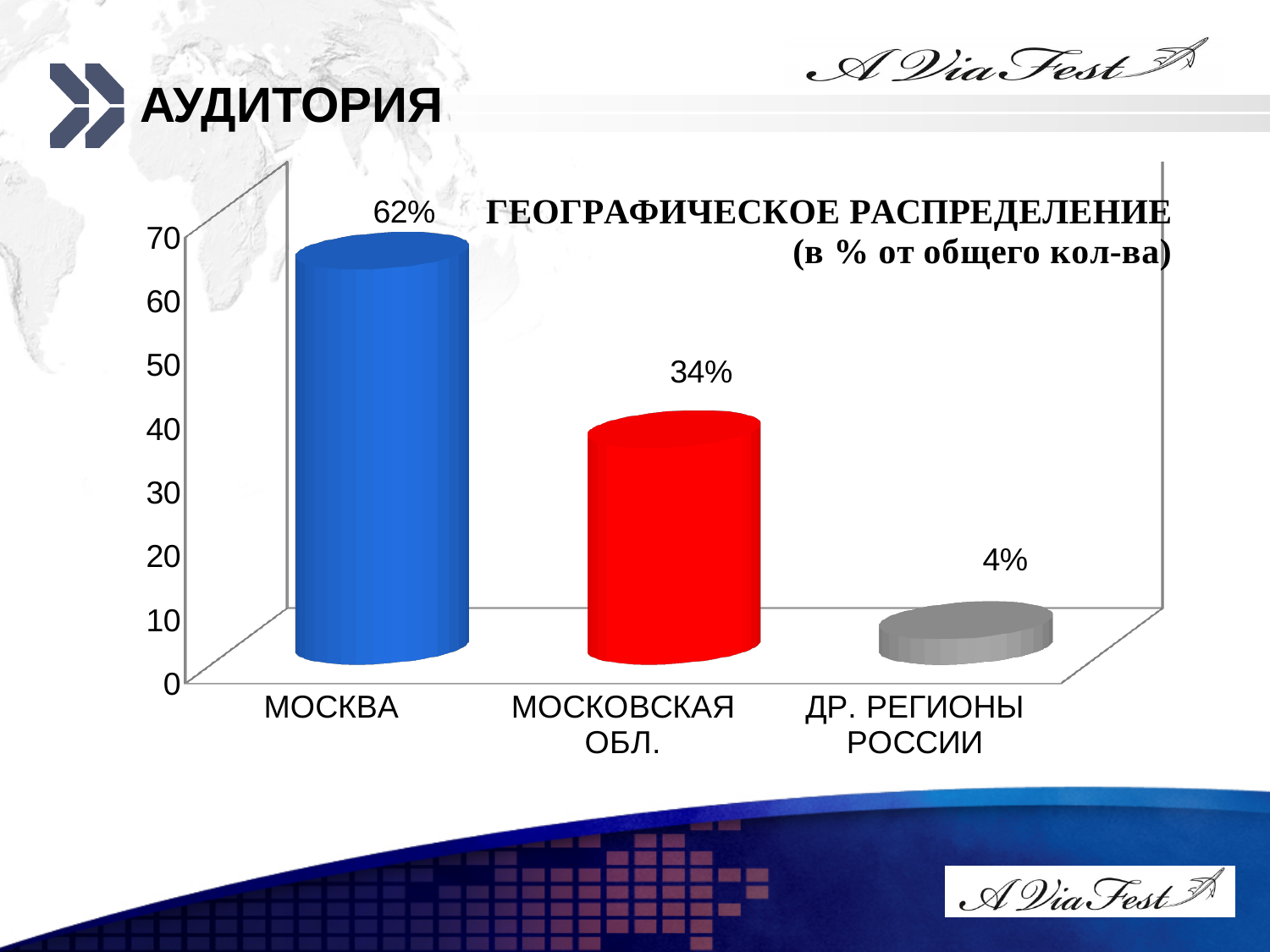
Which is larger, the value for МОСКОВСКАЯ ОБЛ. or the value for ДР. РЕГИОНЫ РОССИИ? МОСКОВСКАЯ ОБЛ. Which category has the lowest value? ДР. РЕГИОНЫ РОССИИ Is the value for МОСКВА greater or less than 50? greater What kind of chart is shown on the slide? bar chart What is the value for ДР. РЕГИОНЫ РОССИИ? 4% What is the title of the chart? ГЕОГРАФИЧЕСКОЕ РАСПРЕДЕЛЕНИЕ (в % от общего кол-ва) What is the value for МОСКВА? 62% What is the difference between the values for МОСКВА and МОСКОВСКАЯ ОБЛ.? 28% What is the value for МОСКОВСКАЯ ОБЛ.? 34% What is the difference between the values for МОСКОВСКАЯ ОБЛ. and ДР. РЕГИОНЫ РОССИИ? 30% How many categories are shown in the chart? 3 Which category has the highest value? МОСКВА